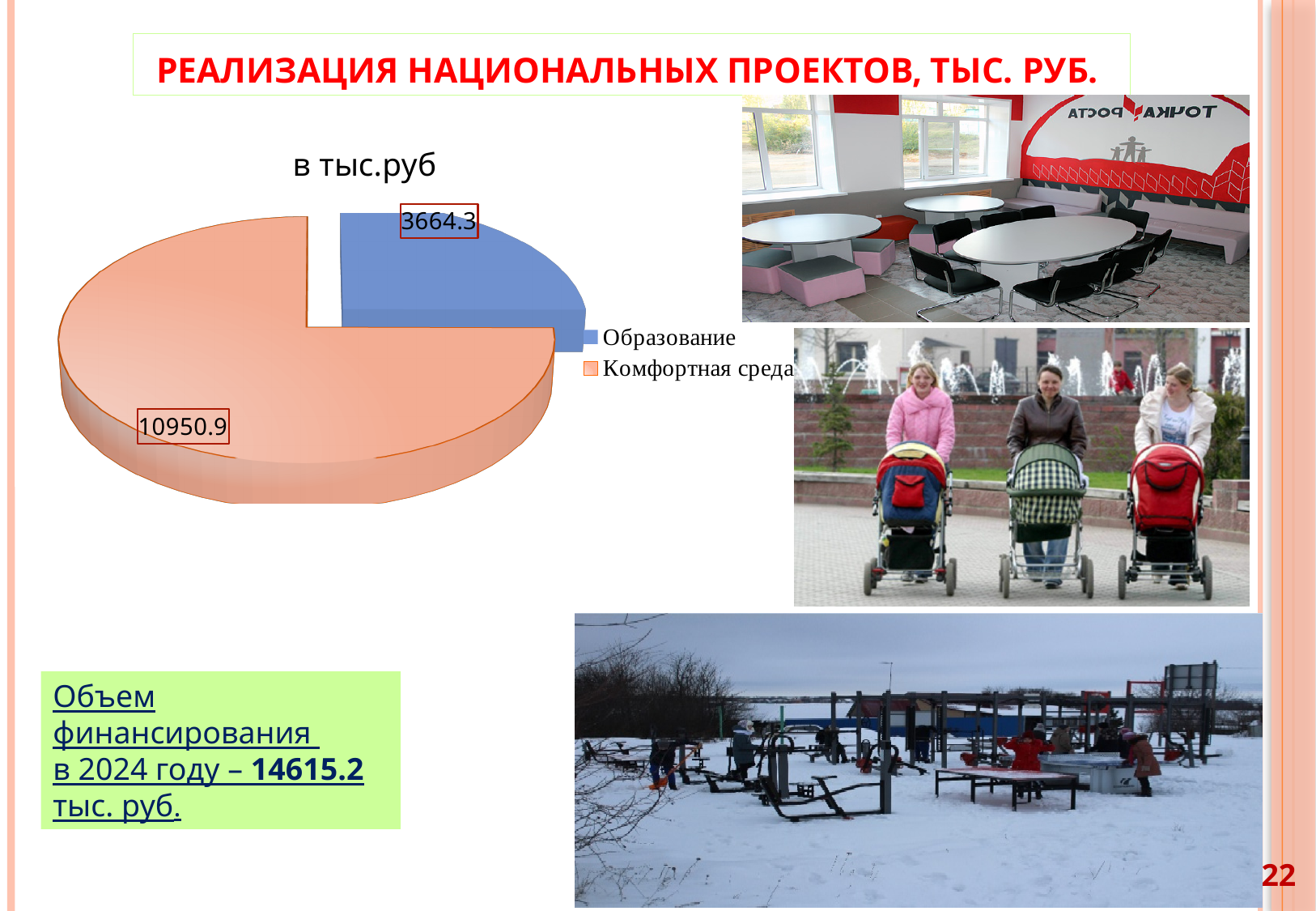
What is the value for Образование in the pie chart? 3664.3 What type of chart is shown on the slide? pie chart How many slices does the pie chart have? 2 What is the total of the two values shown in the pie chart? 14615.2 What colour is the Образование slice in the pie chart? blue Which category has the smallest slice in the pie chart? Образование What is the difference between the values for Комфортная среда and Образование? 7286.6 Which is larger: the value for Образование or the value for Комфортная среда? Комфортная среда Which category has the largest slice in the pie chart? Комфортная среда What is the title of the pie chart? в тыс.руб How many entries does the legend of the pie chart list? 2 What is the value for Комфортная среда in the pie chart? 10950.9